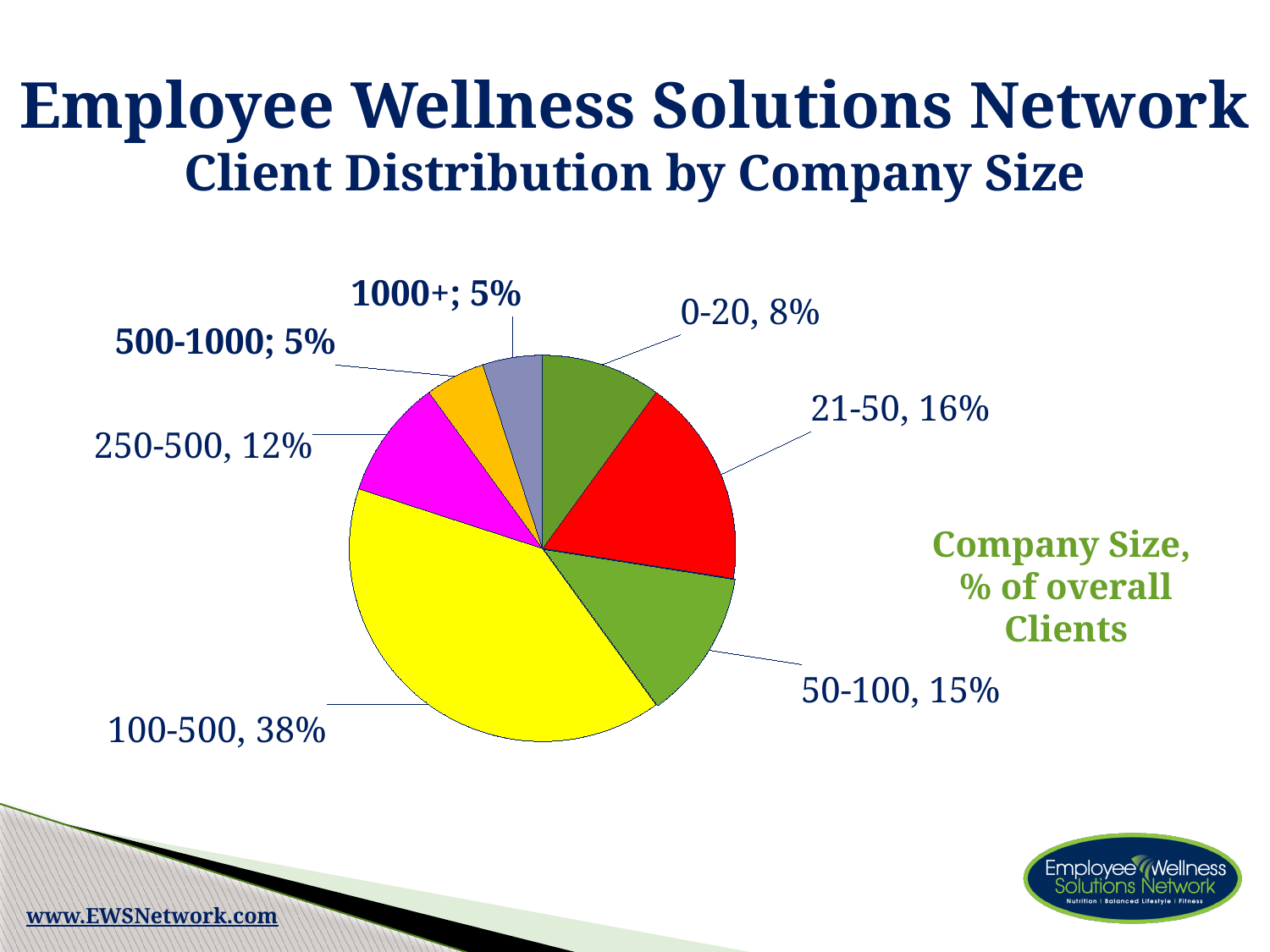
What is the difference in share between the 100-500 and 21-50 categories? 22% Which company size category has the largest share of clients? 100-500 What share of overall clients do companies of size 250-500 represent? 12% What share of overall clients do companies of size 0-20 represent? 8% What is the difference in share between the 0-20 and 1000+ categories? 3% How many company size categories are shown in the pie chart? 7 What kind of chart is shown on the slide? pie chart Which two company size categories each have a 5% share? 500-1000 and 1000+ What share of overall clients do companies of size 21-50 represent? 16% What colour is the slice for the 100-500 category? yellow What share of overall clients do companies of size 100-500 represent? 38% Which has a larger share of clients, 50-100 or 250-500? 50-100